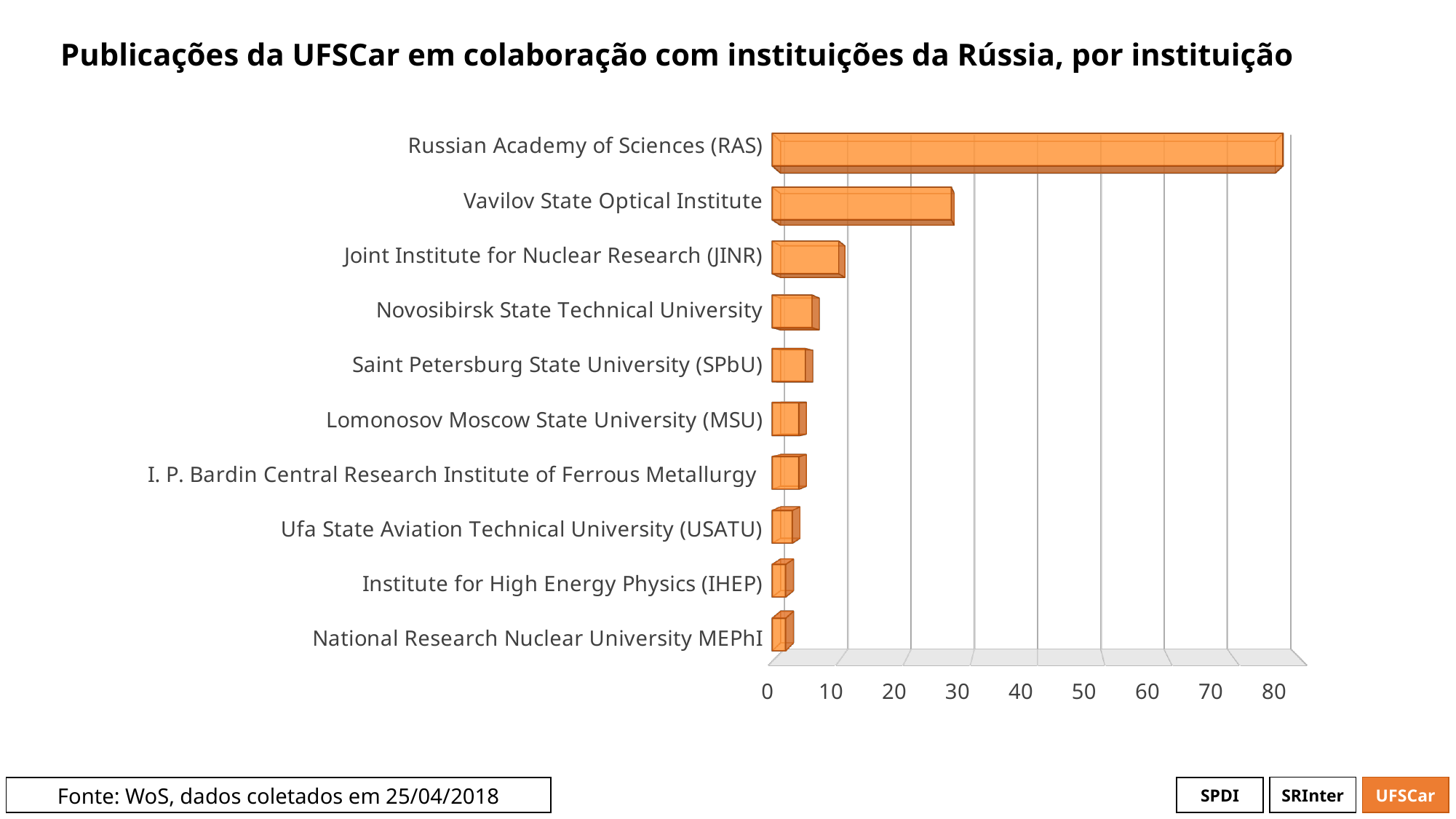
What is the title of the chart? Publicações da UFSCar em colaboração com instituições da Rússia, por instituição Is the value for Saint Petersburg State University (SPbU) greater or less than 10? less Which has more publications: Novosibirsk State Technical University or Lomonosov Moscow State University (MSU)? Novosibirsk State Technical University Is the value for Vavilov State Optical Institute greater or less than 20? greater Is the value for Novosibirsk State Technical University greater or less than 10? less Which has more publications: Vavilov State Optical Institute or Joint Institute for Nuclear Research (JINR)? Vavilov State Optical Institute What kind of chart is shown on the slide? bar chart How many institutions are shown in the chart? 10 Which institution has the highest number of publications in collaboration with UFSCar? Russian Academy of Sciences (RAS) Do the bar values increase or decrease going from the top institution to the bottom institution? decrease